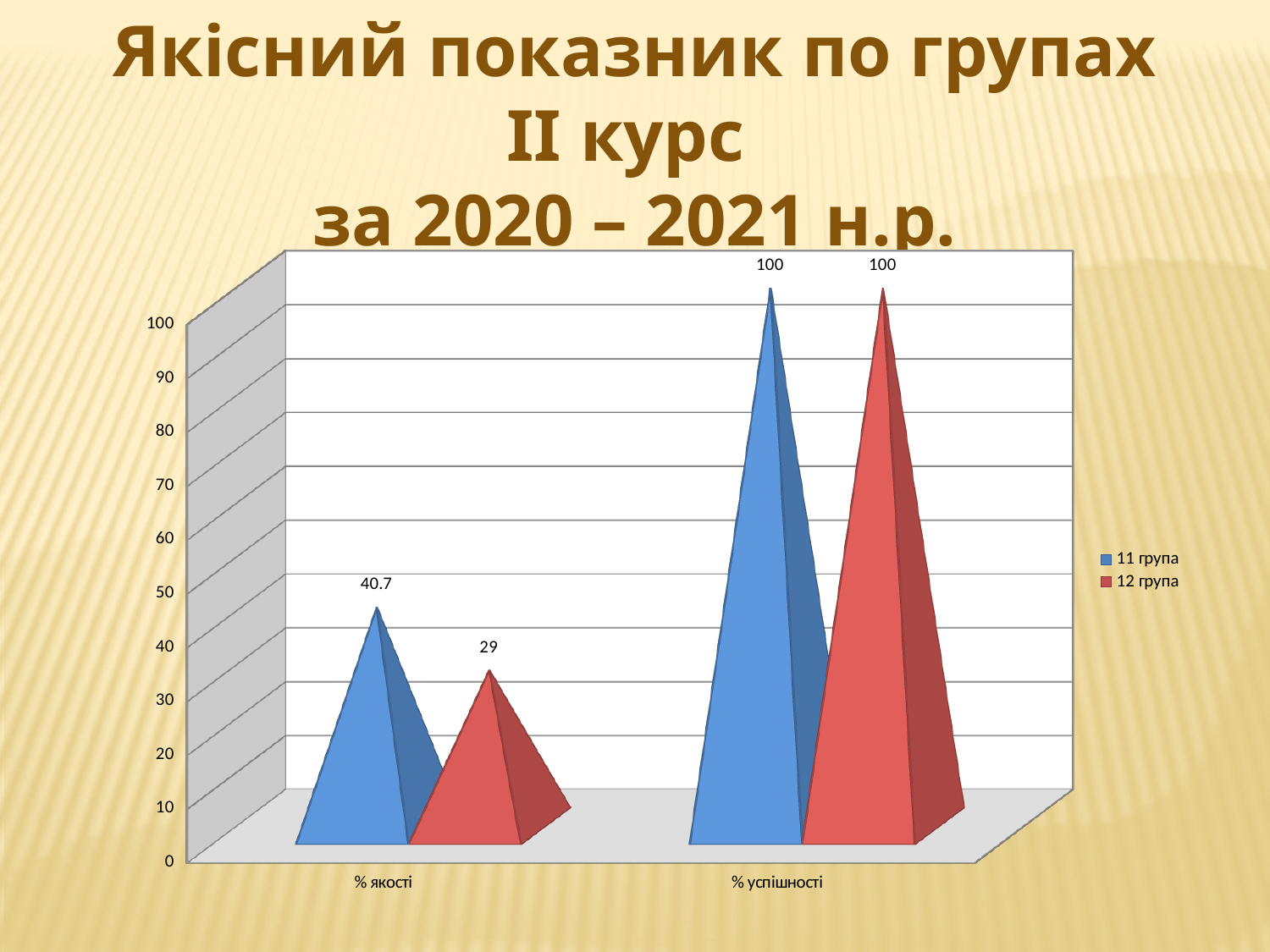
What is the value for 12 група in the % якості category? 29 What is the value for 11 група in the % успішності category? 100 What is the difference between the 11 група and 12 група values in the % якості category? 11.7 Is the value for 12 група in the % якості category greater or less than 30? less Which series has the lowest value shown on the chart? 12 група Which group has the higher value in the % якості category? 11 група Which colour represents 12 група in the chart? red How many series does the legend list? 2 What is the value for 12 група in the % успішності category? 100 What kind of chart is shown on the slide? bar chart How many categories are shown on the x axis? 2 What is the value for 11 група in the % якості category? 40.7